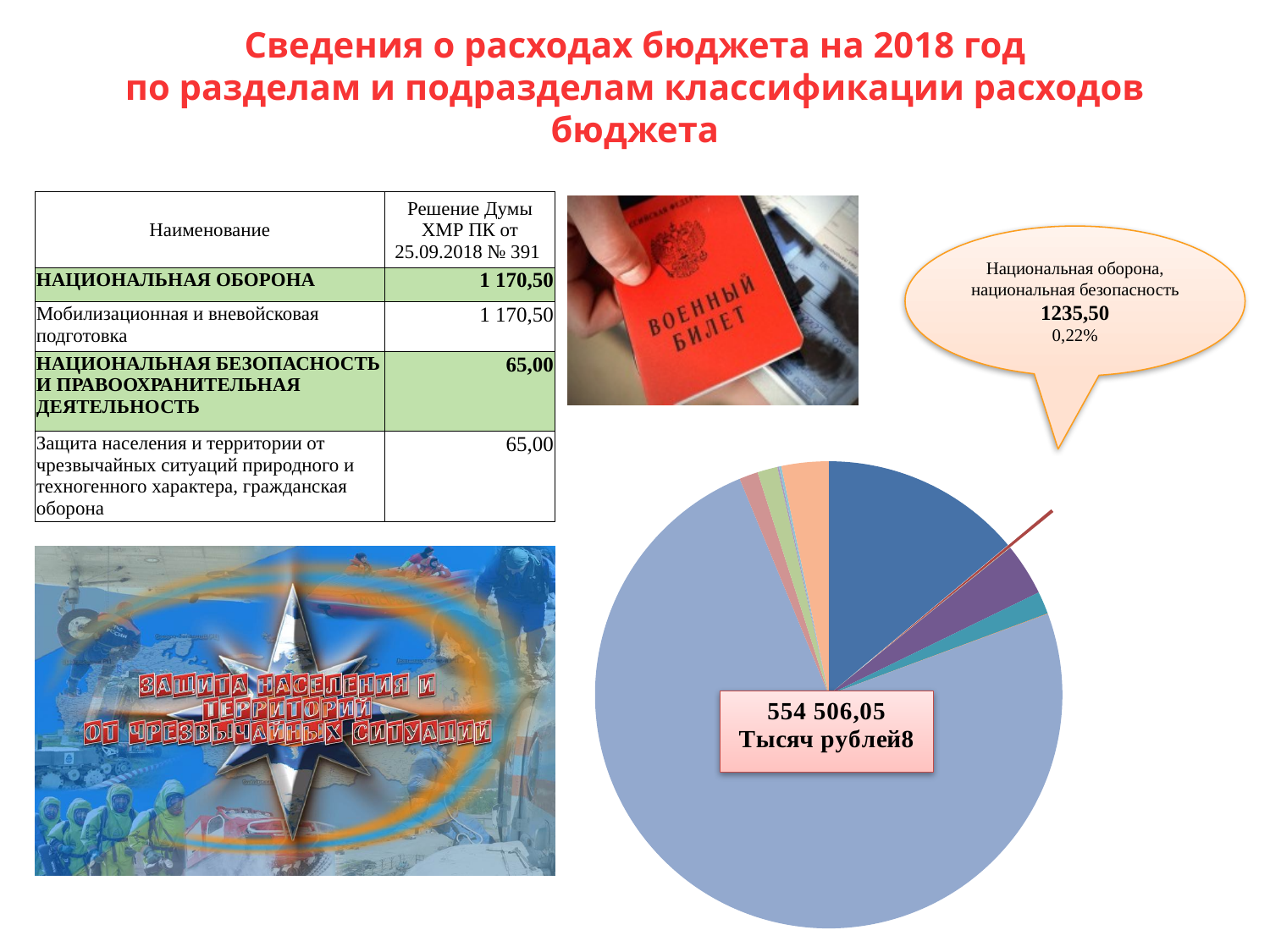
Is the share for "Национальная оборона, национальная безопасность" shown in the callout greater or less than 1%? less Which is larger in the pie chart: the light blue slice or the dark blue slice? light blue In what units is the total in the centre of the pie chart expressed? Тысяч рублей What value does the callout on the pie chart give for "Национальная оборона, национальная безопасность"? 1235,50 What kind of chart is shown on the slide? pie chart What total amount is printed in the box at the centre of the pie chart? 554 506,05 Which colour slice takes up the largest part of the pie chart? light blue According to the callout on the pie chart, what share of the budget goes to "Национальная оборона, национальная безопасность"? 0,22%